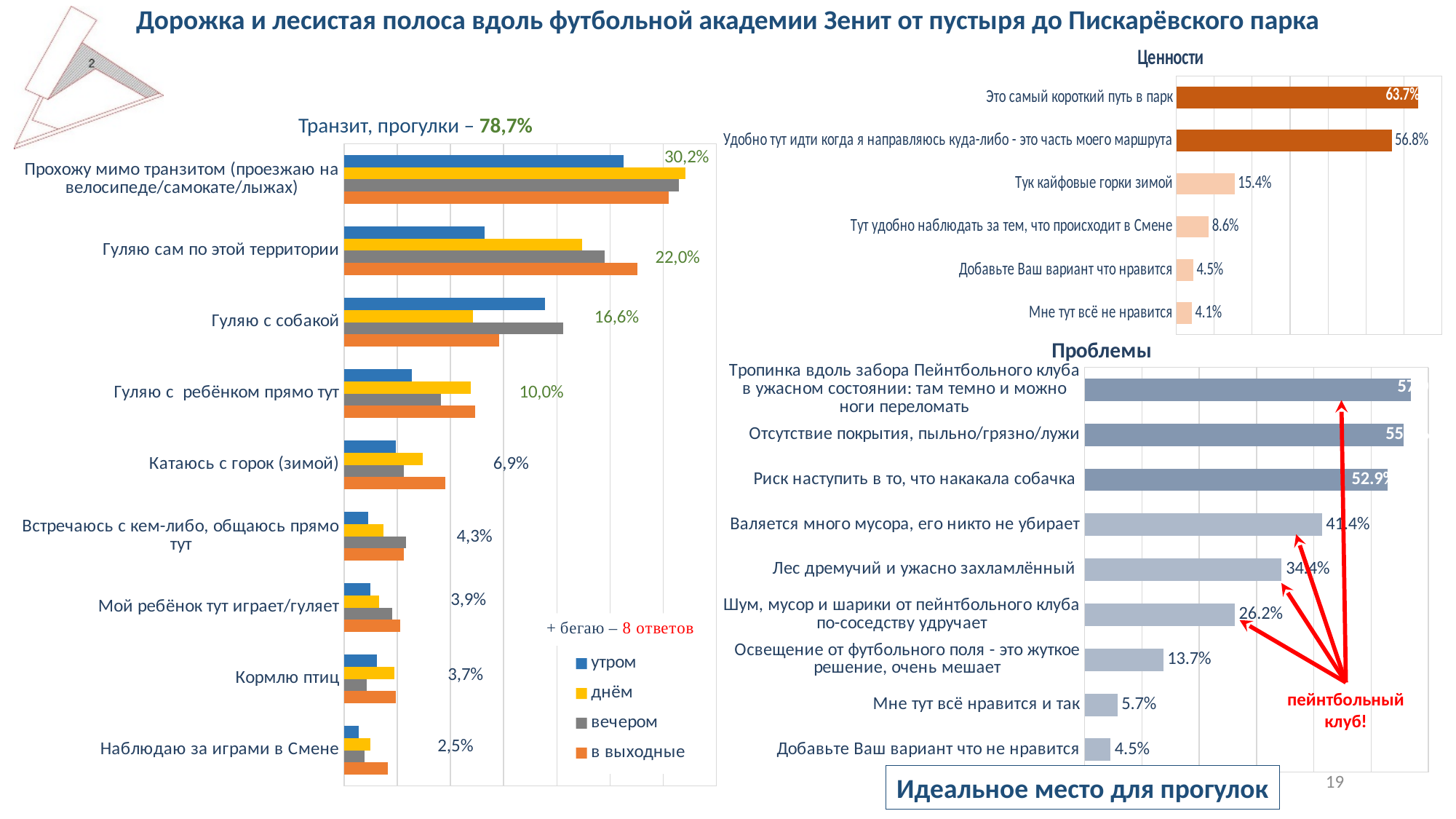
In the 'Транзит, прогулки' chart, what percentage is labelled for 'Гуляю с собакой'? 16,6% In the 'Транзит, прогулки' chart, which series has the longest bar for 'Прохожу мимо транзитом (проезжаю на велосипеде/самокате/лыжах)'? днём How many series does the legend of the 'Транзит, прогулки' chart list? 4 In the 'Ценности' chart, which category has the lowest value? Мне тут всё не нравится What kind of chart is the 'Транзит, прогулки' chart? bar chart In the 'Ценности' chart, what is the difference between 'Это самый короткий путь в парк' and 'Удобно тут идти когда я направляюсь куда-либо - это часть моего маршрута'? 6.9% In the 'Проблемы' chart, what is the difference between 'Валяется много мусора, его никто не убирает' and 'Лес дремучий и ужасно захламлённый'? 7.0% In the 'Проблемы' chart, what is the value for 'Шум, мусор и шарики от пейнтбольного клуба по-соседству удручает'? 26.2% In the 'Проблемы' chart, what is the value for 'Риск наступить в то, что накакала собачка'? 52.9% In the 'Ценности' chart, what is the value for 'Это самый короткий путь в парк'? 63.7% In the 'Проблемы' chart, which is larger: 'Валяется много мусора, его никто не убирает' or 'Лес дремучий и ужасно захламлённый'? Валяется много мусора, его никто не убирает How many categories are shown in the 'Ценности' chart? 6